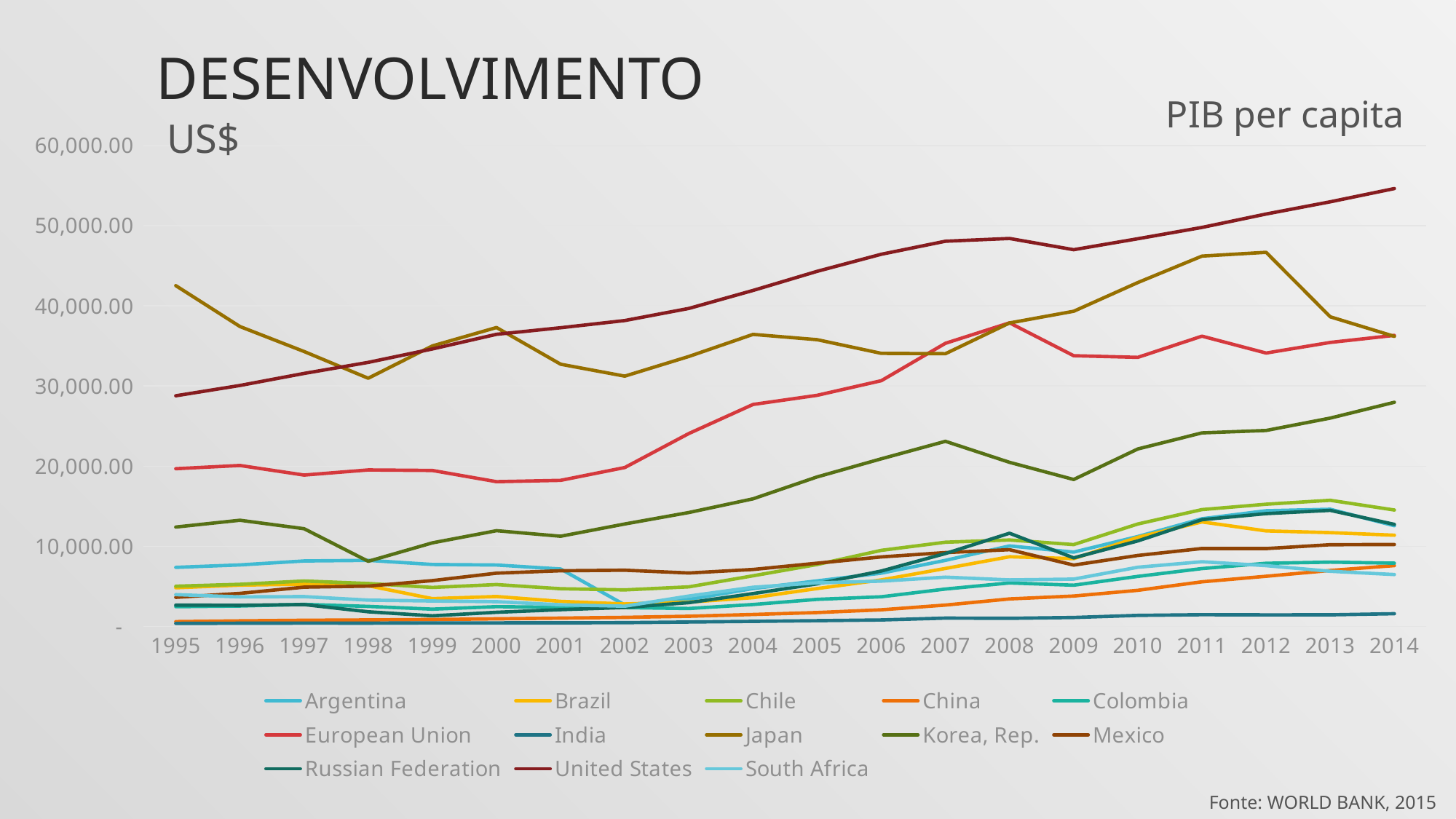
How many years are shown along the x axis? 20 What source is cited at the bottom of the slide? WORLD BANK, 2015 Which series has the lowest value in 2014? India Is the value for European Union in 2001 greater or less than 20,000.00? less Is the value for United States in 2014 greater or less than 50,000.00? greater What kind of chart is shown on the slide? line chart Which series has the highest value in 2014? United States In 1995, which is larger: the value for Japan or the value for United States? Japan How many series does the legend list? 13 Which series has the highest value in 1995? Japan Does the United States line generally rise or fall from 1995 to 2014? rise Is the value for Korea, Rep. in 2014 greater or less than 30,000.00? less